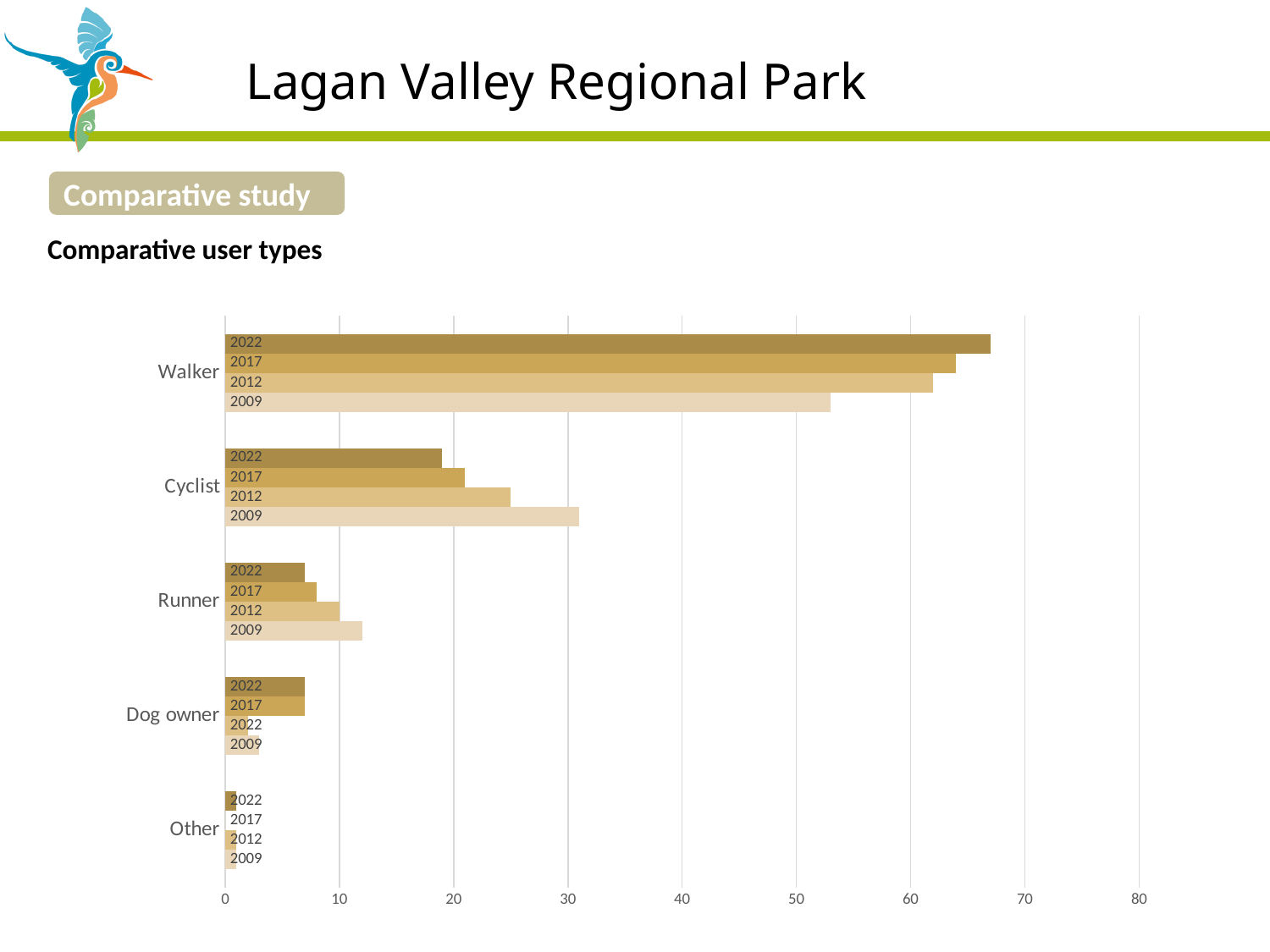
How many user type categories are shown on the chart? 5 Which years are compared for each user type on the chart? 2022, 2017, 2012, 2009 Which user type has the lowest values on the chart? Other For Cyclist, do the values rise or fall from 2009 to 2022? fall Is the value for Runner in 2009 greater or less than 20? less What kind of chart is shown on the slide? bar chart Which user type has the highest values on the chart? Walker Is the value for Cyclist in 2012 greater or less than 30? less For Walker, which year has the larger value, 2022 or 2009? 2022 Is the value for Walker in 2022 greater or less than 60? greater For Cyclist, which year has the larger value, 2009 or 2022? 2009